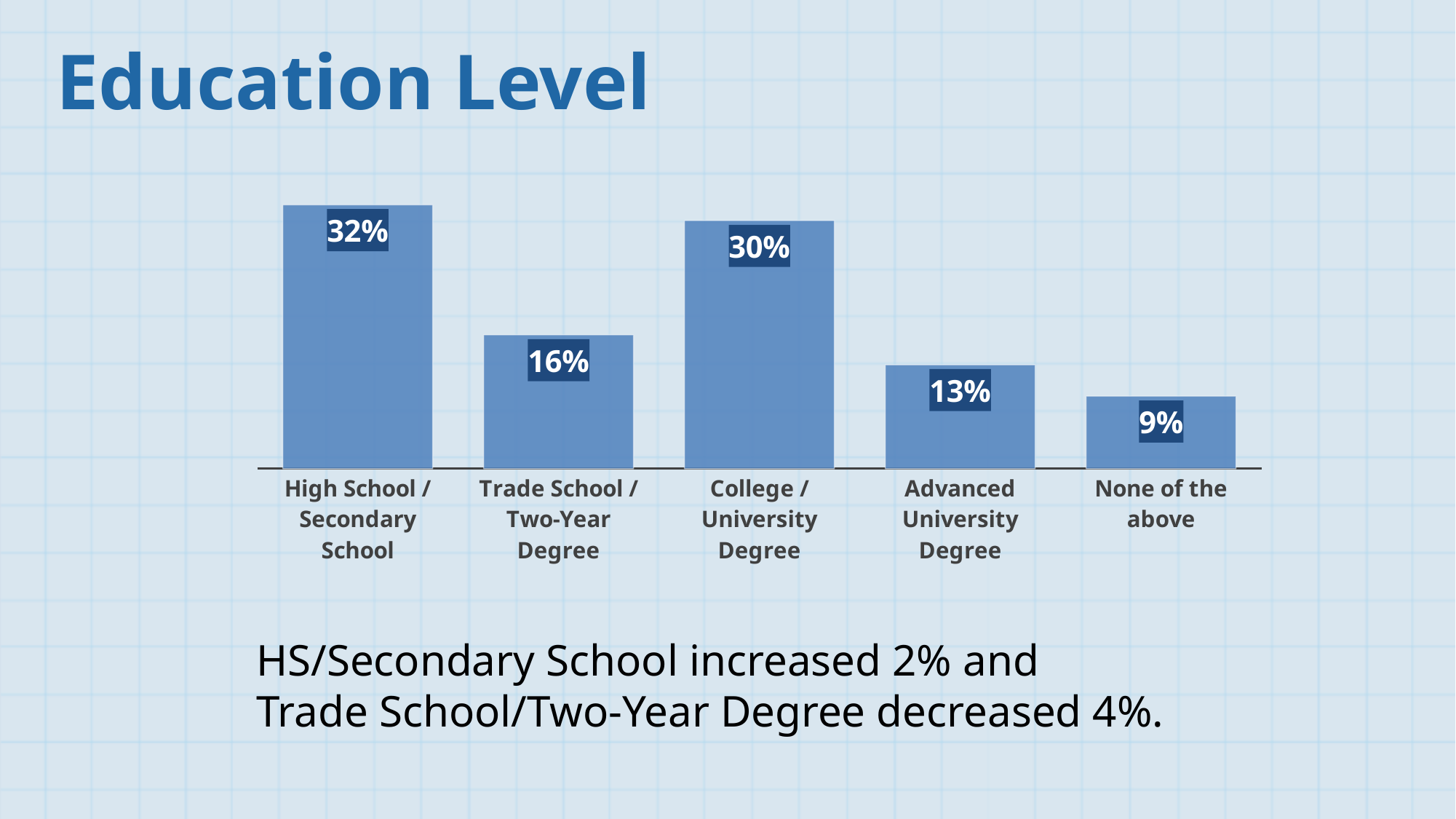
What percentage is shown for Advanced University Degree? 13% What percentage is shown for College / University Degree? 30% Which education level has the highest percentage? High School / Secondary School What is the difference between the High School / Secondary School and College / University Degree percentages? 2% What percentage is shown for High School / Secondary School? 32% What type of chart is shown on the slide? Bar chart What is the difference between the Trade School / Two-Year Degree and Advanced University Degree percentages? 3% How many education level categories are shown in the chart? 5 Which is larger, the value for Trade School / Two-Year Degree or the value for Advanced University Degree? Trade School / Two-Year Degree What percentage is shown for Trade School / Two-Year Degree? 16% Which category has the lowest percentage? None of the above What percentage is shown for None of the above? 9%